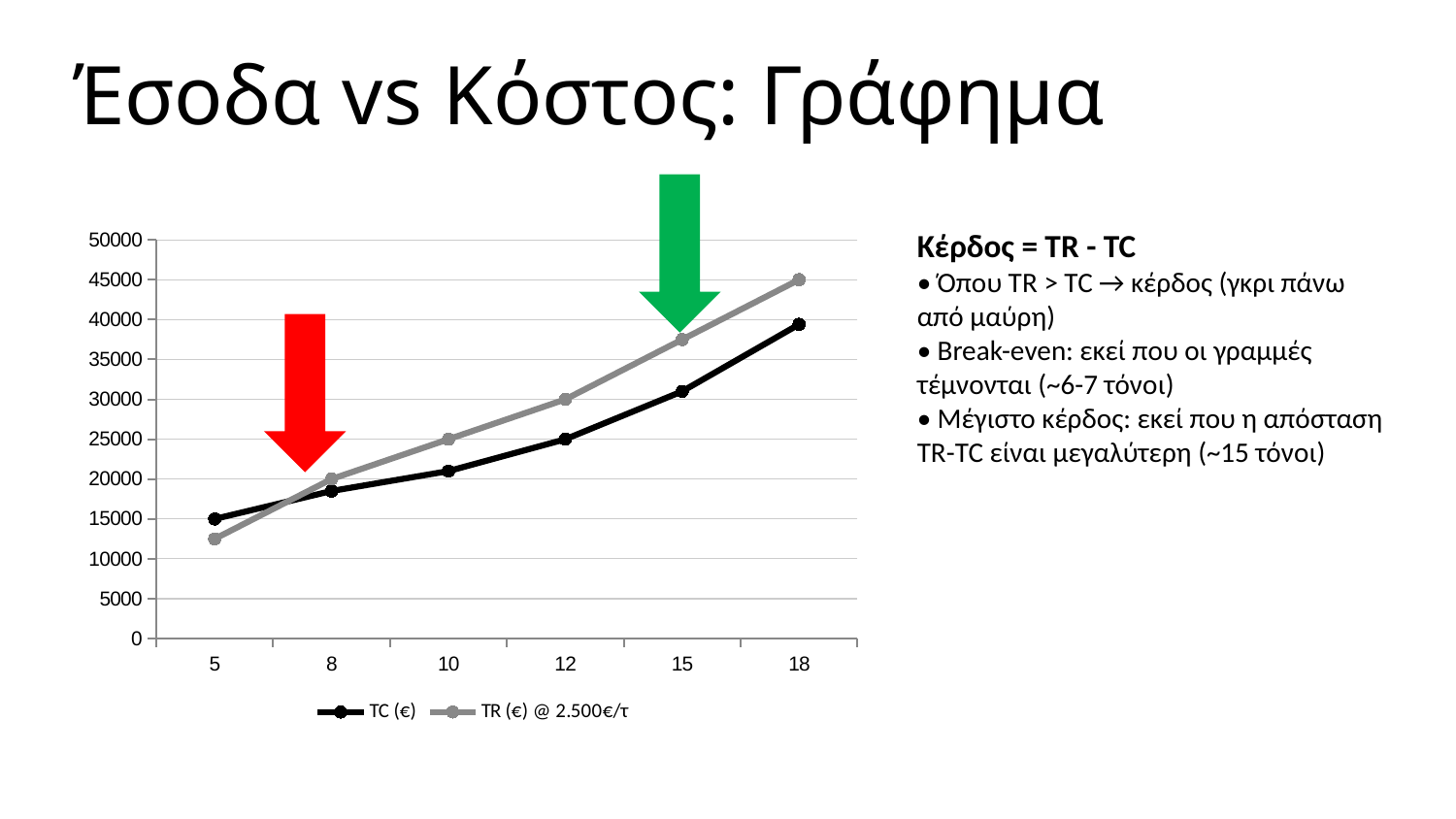
What kind of chart is shown on the slide? line chart At x = 18, which series has the larger value, TC (€) or TR (€) @ 2.500€/τ? TR (€) @ 2.500€/τ How many points are plotted along the x axis for each series? 6 Do the values of TC (€) rise or fall as x increases from 5 to 18? rise At x = 5, which series has the larger value, TC (€) or TR (€) @ 2.500€/τ? TC (€) What is the value of TR (€) @ 2.500€/τ at x = 18? 45000 What colour is the line for the TC (€) series? black How many series does the chart legend list? 2 Is the value of TR (€) @ 2.500€/τ at x = 15 greater or less than 35000? greater What is the value of TC (€) at x = 5? 15000 What is the value of TR (€) @ 2.500€/τ at x = 10? 25000